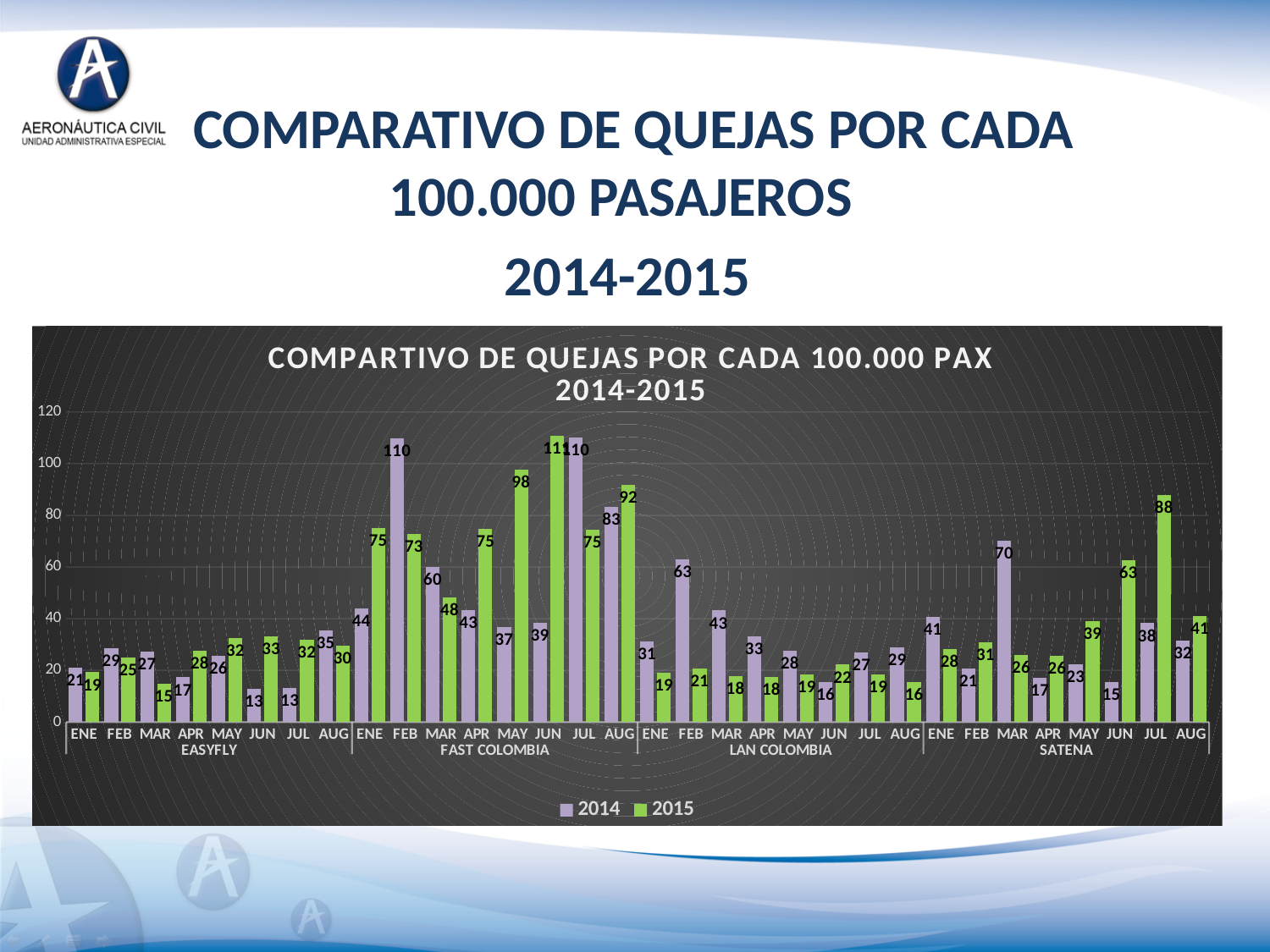
What type of chart is shown on the slide? bar chart How many airline groups are shown on the x axis? 4 What is the difference between the 2014 and 2015 values for MAR under SATENA? 44 Which is larger for JUN under EASYFLY, the 2014 value or the 2015 value? 2015 Which month has the lowest 2014 value under SATENA? JUN How many series does the legend list? 2 What is the 2014 value for FEB under FAST COLOMBIA? 110 What is the 2014 value for FEB under LAN COLOMBIA? 63 What is the 2015 value for MAY under FAST COLOMBIA? 98 Which month has the highest 2015 value under LAN COLOMBIA? JUN What is the 2015 value for JUL under SATENA? 88 Is the 2015 value for AUG under FAST COLOMBIA greater or less than 80? greater